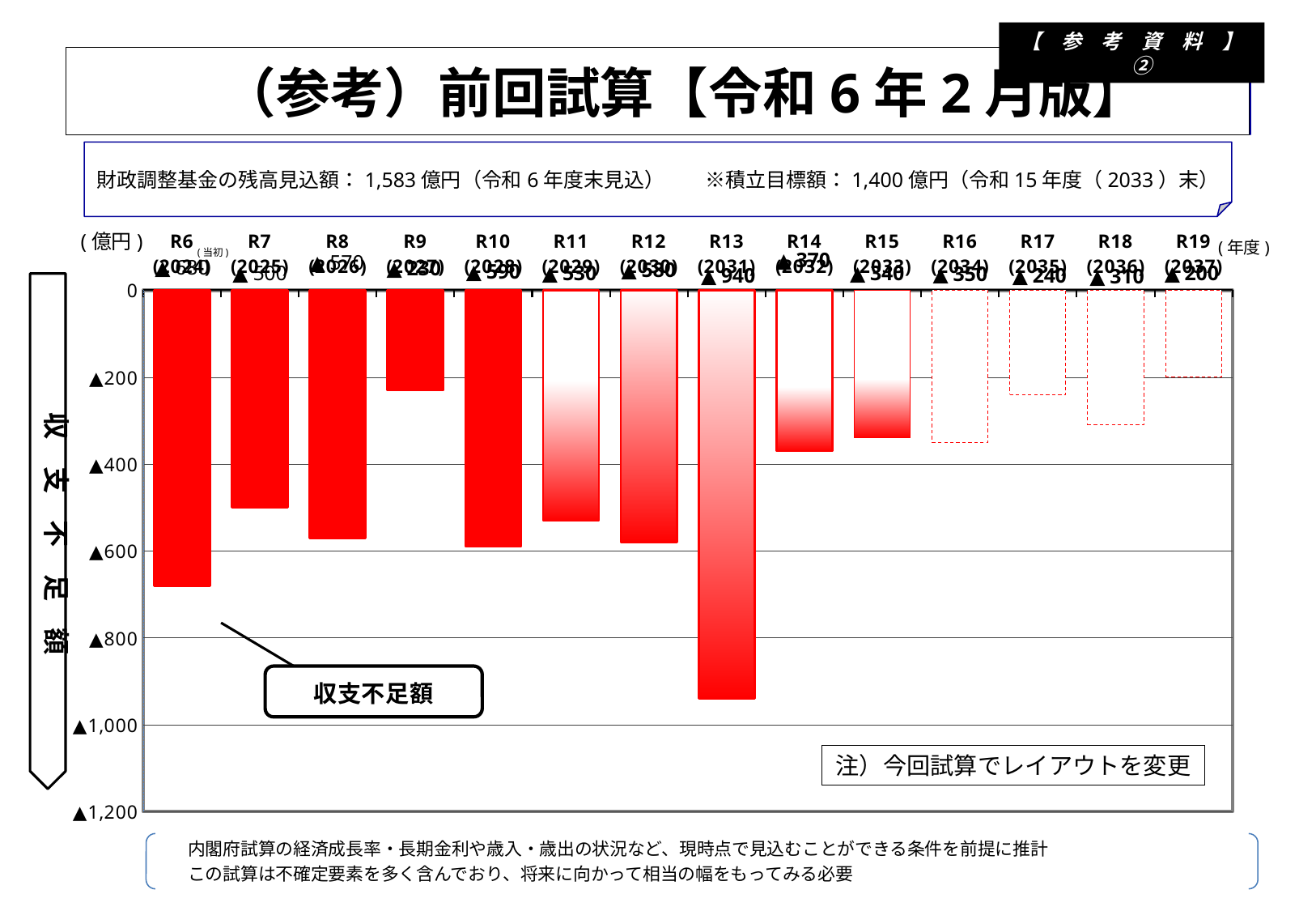
What is the value shown for R7 (2025)? ▲500 How many fiscal years are plotted on the chart? 14 What is the difference between the deficit for R13 (2031) and R10 (2028)? 350 What is the value shown for R11 (2029)? ▲530 What is the value shown for R19 (2037)? ▲200 Which fiscal year has the largest 収支不足額 (deficit)? R13 (2031) Is the deficit for R6 (2024) greater or less than 600? greater Which fiscal year has the smallest 収支不足額 (deficit)? R19 (2037) What is the value shown for R13 (2031)? ▲940 What is the value shown for R15 (2033)? ▲340 What kind of chart is shown on the slide? bar chart Which has the larger deficit, R11 (2029) or R12 (2030)? R12 (2030)